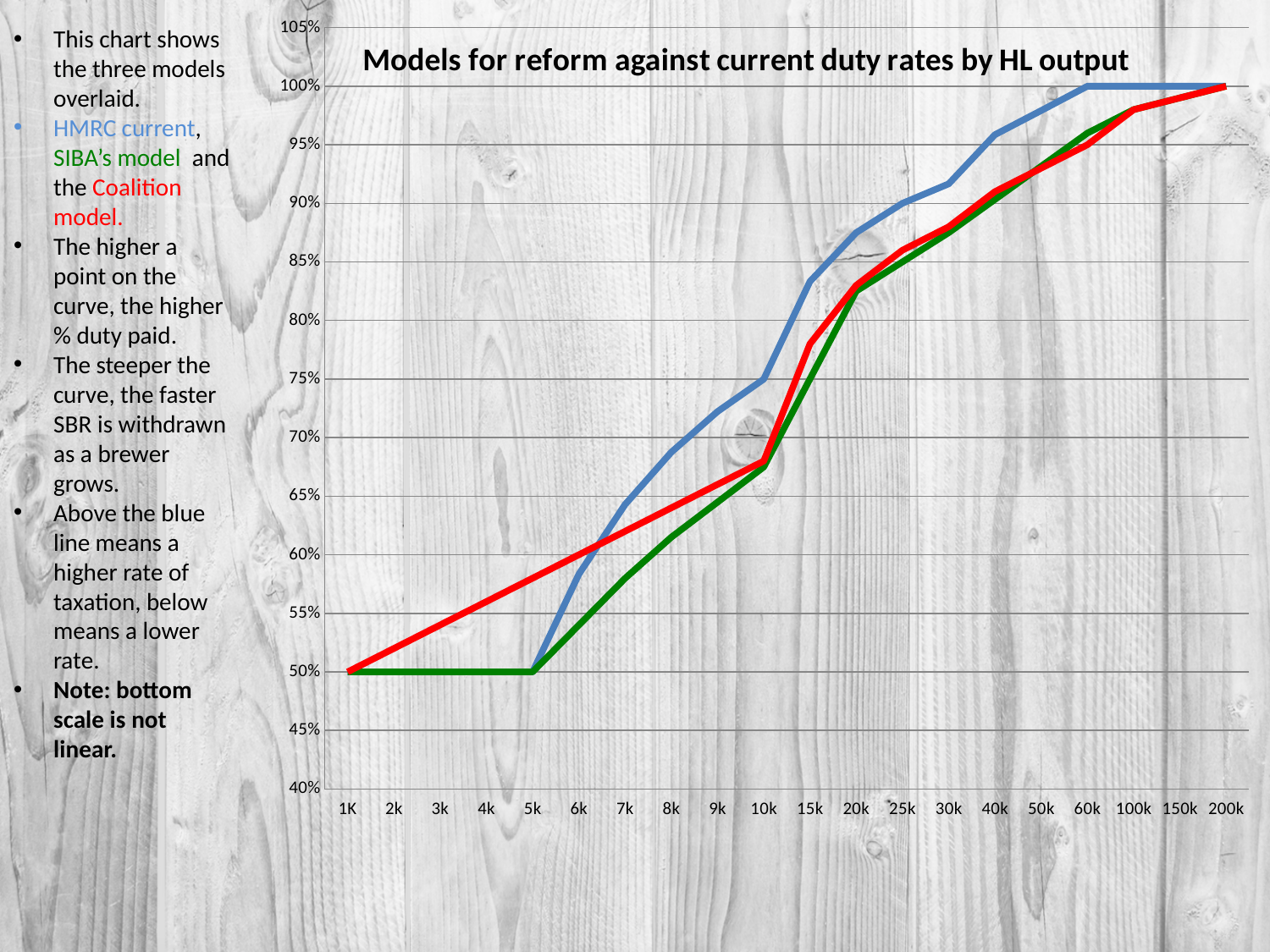
What value does the blue line (HMRC current) reach at 10k? 75% What value do all three lines show at 1K? 50% Do the values of the lines rise or fall as output increases along the x axis? rise How many lines are plotted on the chart? 3 Is the value of the blue line (HMRC current) at 30k greater or less than 90%? greater Is the value of the red line (Coalition model) at 8k greater or less than 65%? less What value does the blue line (HMRC current) reach at 200k? 100% At 5k, which line is higher: the red (Coalition model) or the green (SIBA's model)? red (Coalition model) What value does the green line (SIBA's model) show at 5k? 50% What kind of chart is shown on the slide? line chart What is the title of the chart? Models for reform against current duty rates by HL output How many output categories are labelled along the x axis? 20